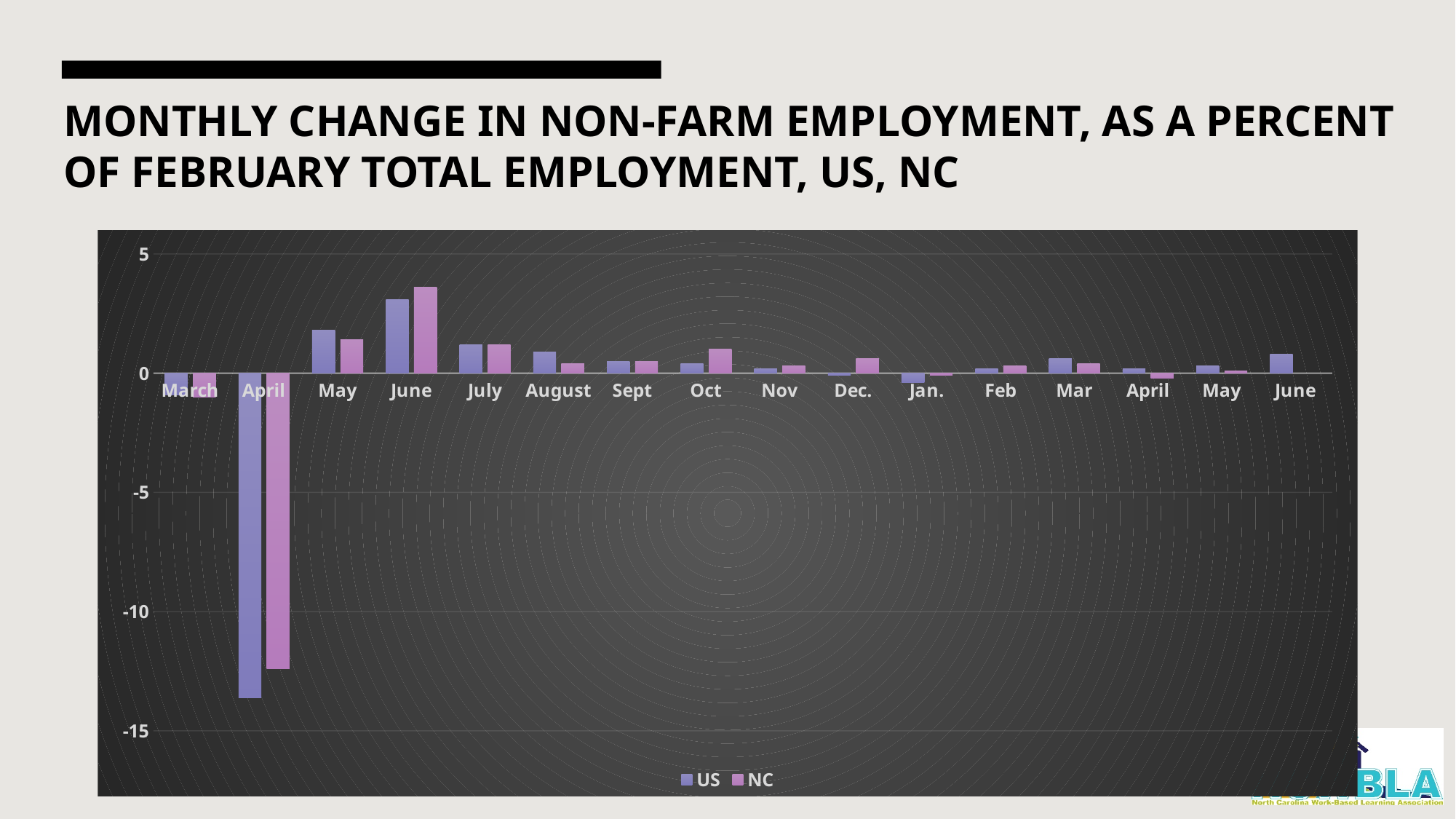
Is the US value for the first April greater or less than -10? less Which month has the lowest value for the US series? April (the first April) What kind of chart is shown on the slide? bar chart In the first May, which series has the larger value, US or NC? US In the first April, which series has the lower (more negative) value, US or NC? US Is the NC value for the first April greater or less than -10? less Which series and month has the highest bar on the chart? NC, first June How many series does the legend list? 2 How many months (categories) are shown along the x axis? 16 Which series is shown in purple-blue in the legend? US Is the NC value for the first June greater or less than 5? less In the first June, which series has the larger value, US or NC? NC